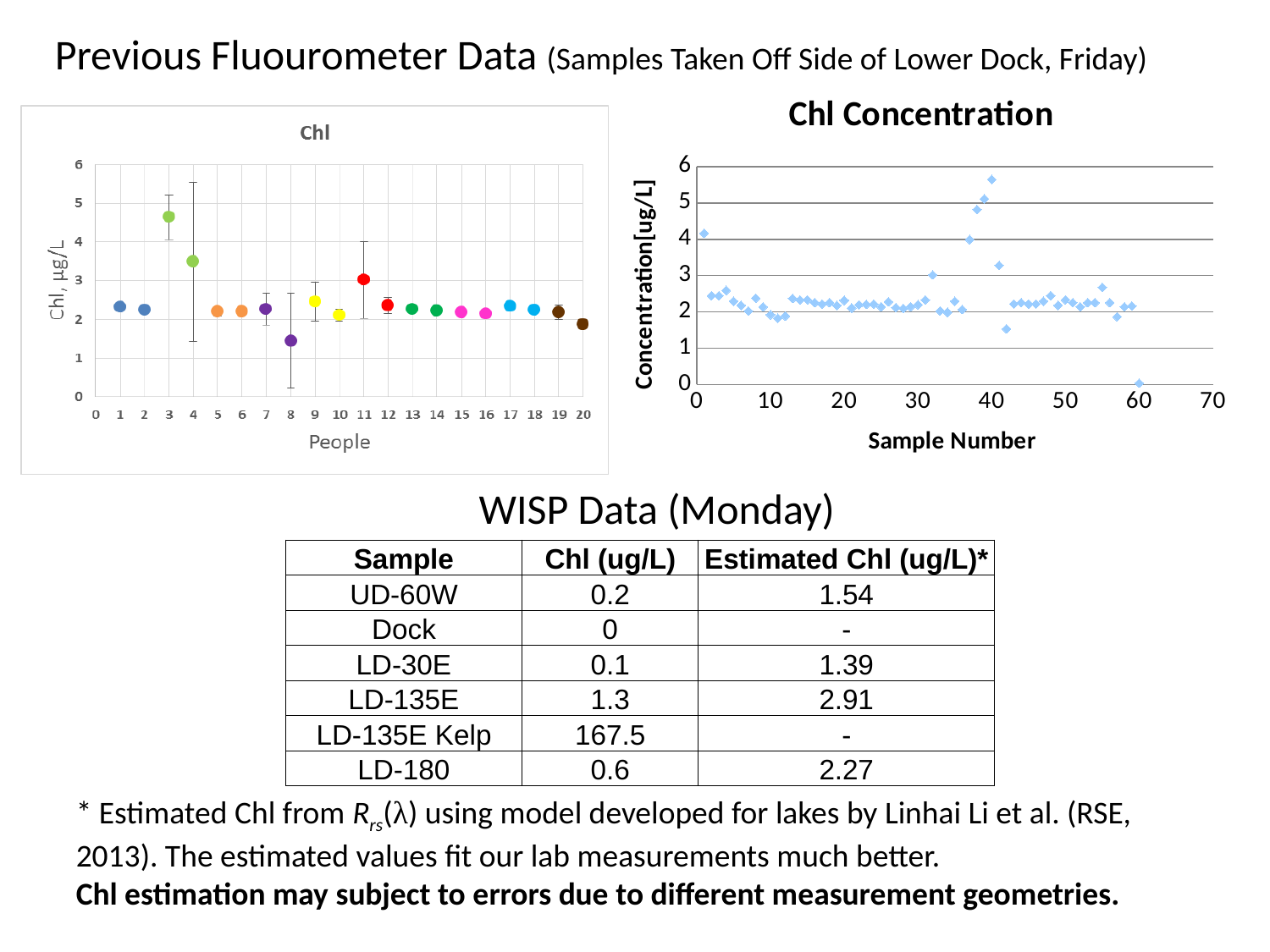
In the right chart titled "Chl Concentration", is the value for sample number 1 greater or less than 4? greater In the left chart titled "Chl", is the value for person 3 greater or less than 4? greater In the left chart titled "Chl", which person number has the highest Chl value? 3 In the left chart titled "Chl", is the value for person 4 greater or less than 3? greater What type of chart is the right chart titled "Chl Concentration"? scatter chart What type of chart is the left chart titled "Chl"? scatter chart In the left chart titled "Chl", how many people (data points) are plotted? 20 In the left chart titled "Chl", what is the label of the x axis? People In the right chart titled "Chl Concentration", what is the label of the y axis? Concentration[ug/L] In the left chart titled "Chl", which person number has the lowest Chl value? 8